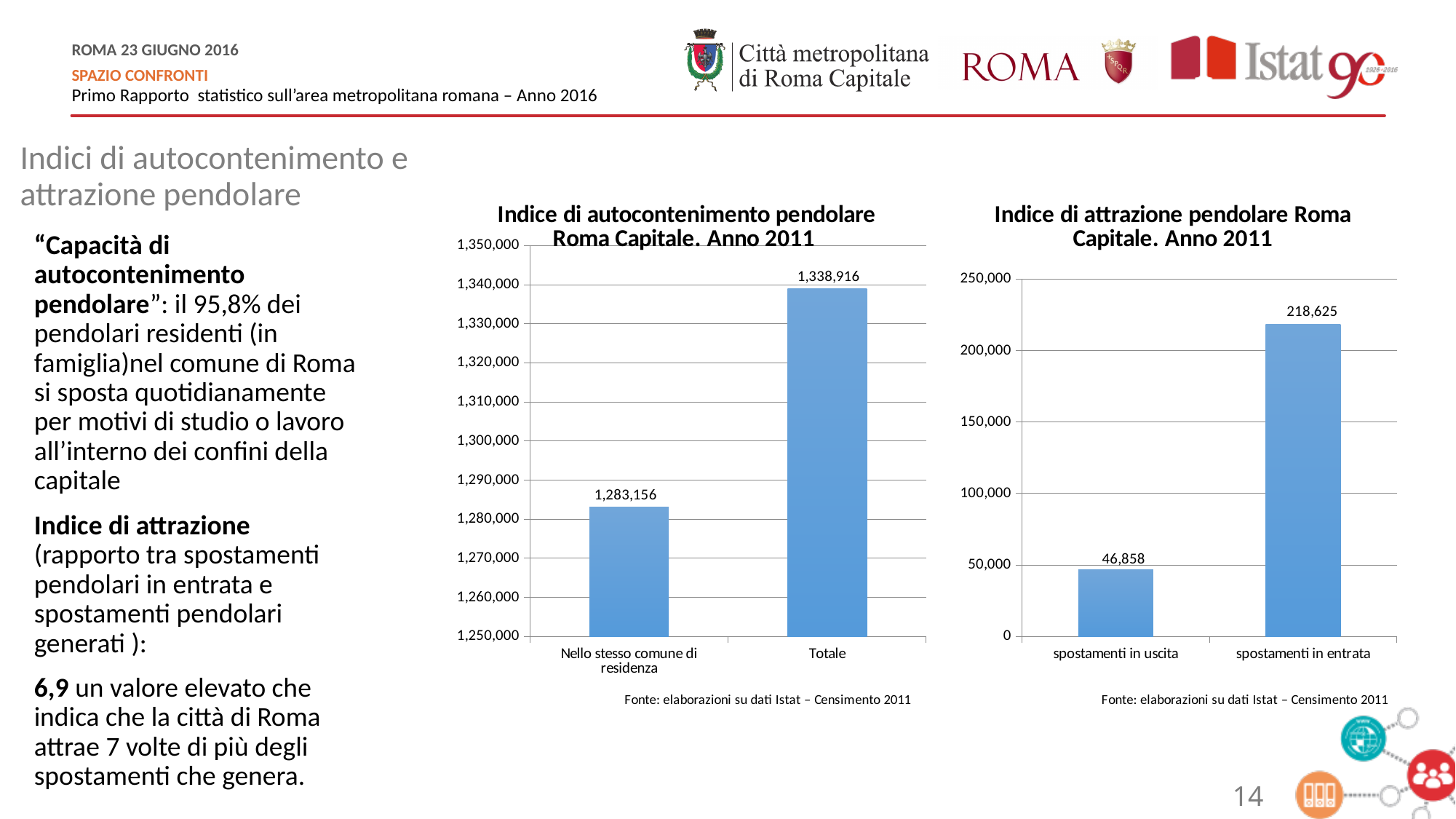
What kind of chart is the chart titled "Indice di autocontenimento pendolare Roma Capitale. Anno 2011"? bar chart In the chart titled "Indice di autocontenimento pendolare Roma Capitale. Anno 2011", what is the difference between "Totale" and "Nello stesso comune di residenza"? 55,760 What is the source cited below the chart titled "Indice di attrazione pendolare Roma Capitale. Anno 2011"? Fonte: elaborazioni su dati Istat – Censimento 2011 In the chart titled "Indice di autocontenimento pendolare Roma Capitale. Anno 2011", what is the value for "Nello stesso comune di residenza"? 1,283,156 In the chart titled "Indice di attrazione pendolare Roma Capitale. Anno 2011", what is the value for "spostamenti in entrata"? 218,625 In the chart titled "Indice di autocontenimento pendolare Roma Capitale. Anno 2011", which category has the lowest value? Nello stesso comune di residenza In the chart titled "Indice di attrazione pendolare Roma Capitale. Anno 2011", what is the value for "spostamenti in uscita"? 46,858 In the chart titled "Indice di autocontenimento pendolare Roma Capitale. Anno 2011", what is the value for "Totale"? 1,338,916 In the chart titled "Indice di attrazione pendolare Roma Capitale. Anno 2011", is the value for "spostamenti in uscita" greater or less than 50,000? less How many categories are shown in the chart titled "Indice di attrazione pendolare Roma Capitale. Anno 2011"? 2 In the chart titled "Indice di attrazione pendolare Roma Capitale. Anno 2011", which category has the highest value? spostamenti in entrata In the chart titled "Indice di attrazione pendolare Roma Capitale. Anno 2011", what is the difference between "spostamenti in entrata" and "spostamenti in uscita"? 171,767